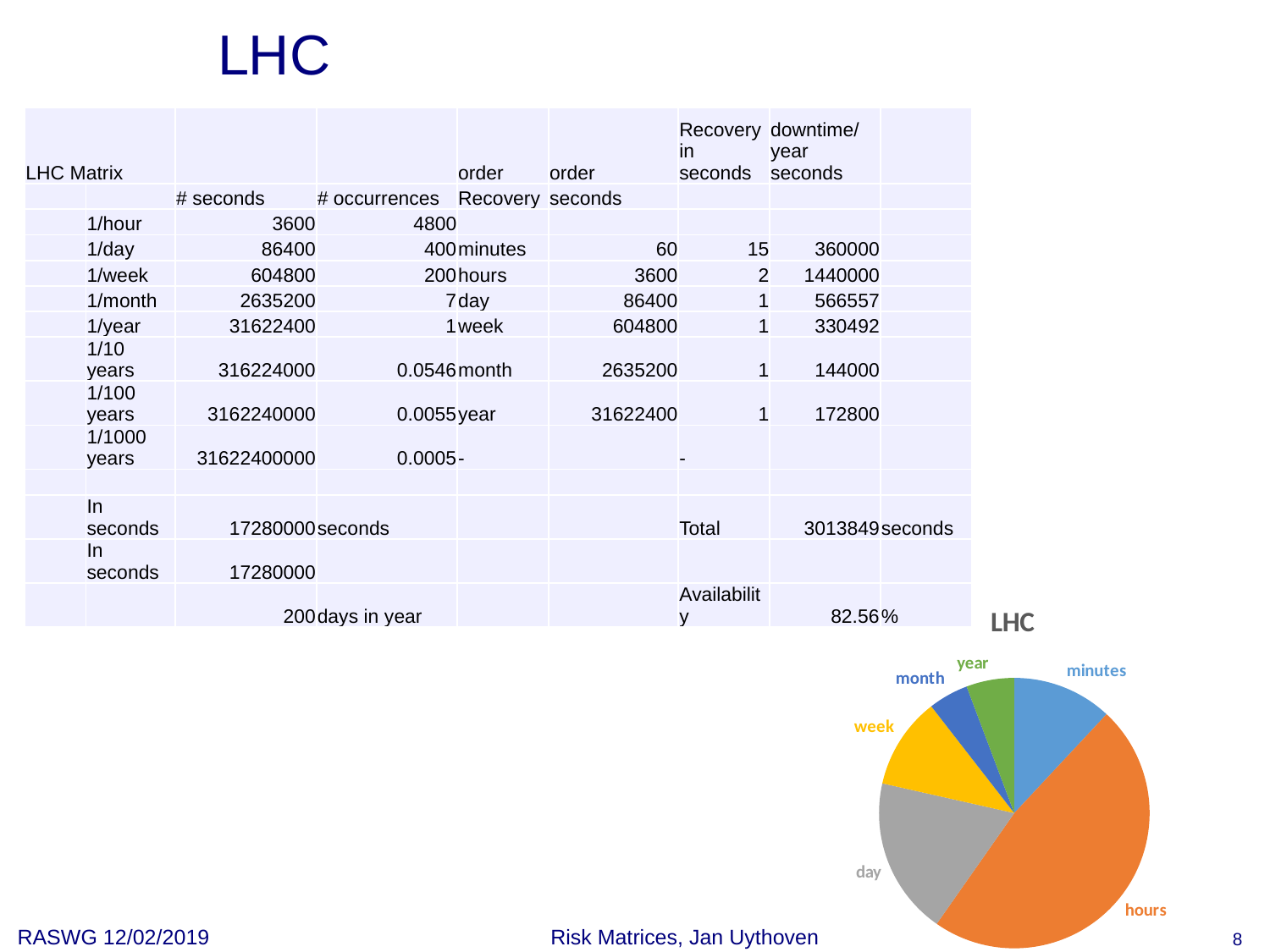
Which slice is larger in the pie chart, hours or day? hours Which slice is larger in the pie chart, day or minutes? day Which slice is larger in the pie chart, week or month? week How many slices does the pie chart have? 6 What kind of chart is shown on the slide? pie chart What colour is the hours slice in the pie chart? orange Which slice of the pie chart is the largest? hours What is the title of the pie chart? LHC